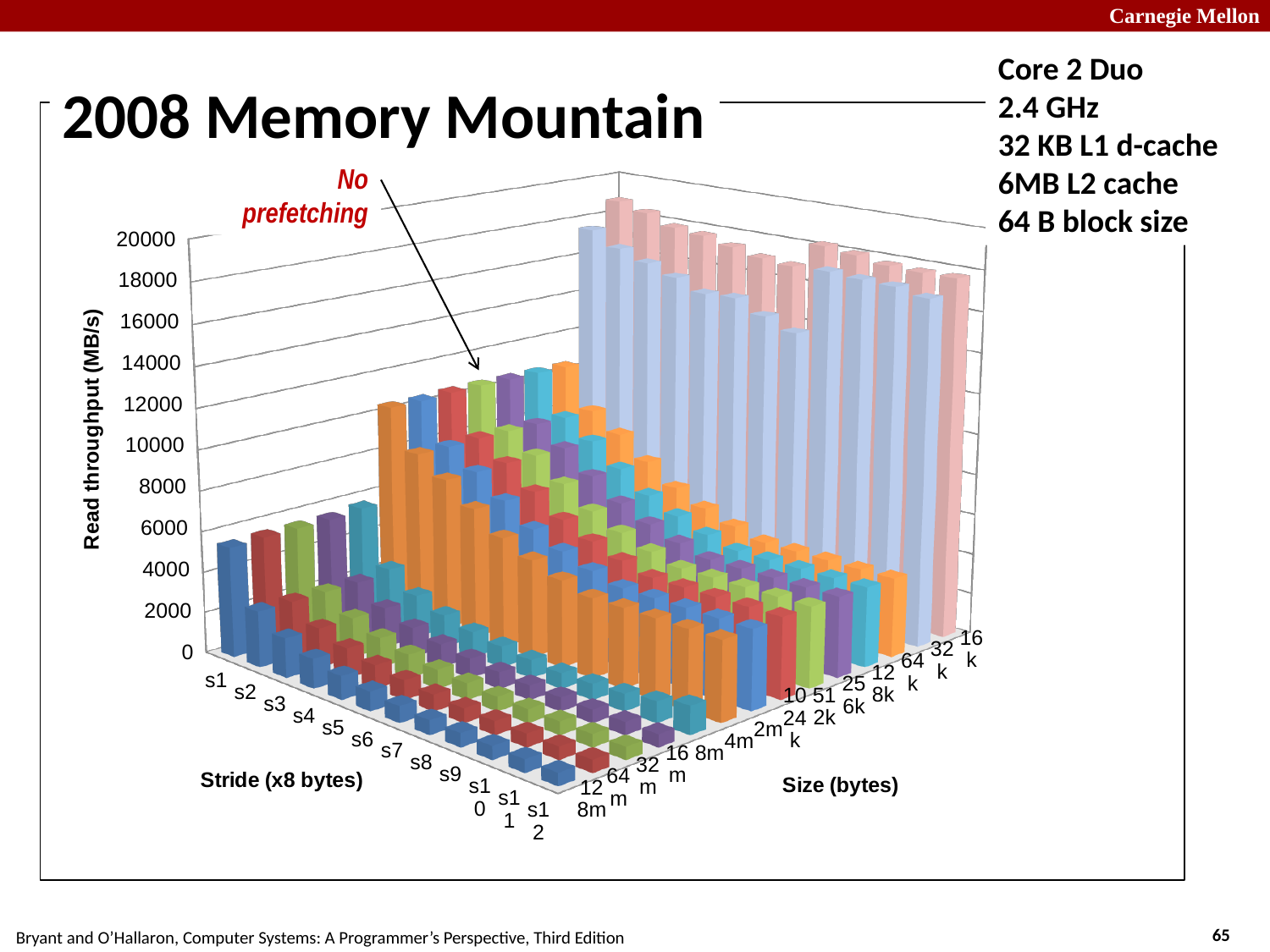
What kind of chart is shown on the slide? 3D bar chart What is the title of the chart on the slide? 2008 Memory Mountain What is the label of the vertical axis of the chart? Read throughput (MB/s) Is the read throughput for stride s12 at size 8m greater or less than 2000? less For size 8m, which stride has the highest read throughput? s1 How many stride categories (s1 through s12) are shown on the stride axis? 12 Is the read throughput for stride s1 at size 8m greater or less than 4000? greater Is the read throughput for stride s1 at size 16k greater or less than 16000? greater What is the highest tick value shown on the Read throughput axis? 20000 How many size categories are shown on the Size (bytes) axis? 14 At size 8m, which has the larger read throughput: stride s1 or stride s12? s1 For size 8m, does read throughput rise or fall as the stride increases from s1 to s12? fall